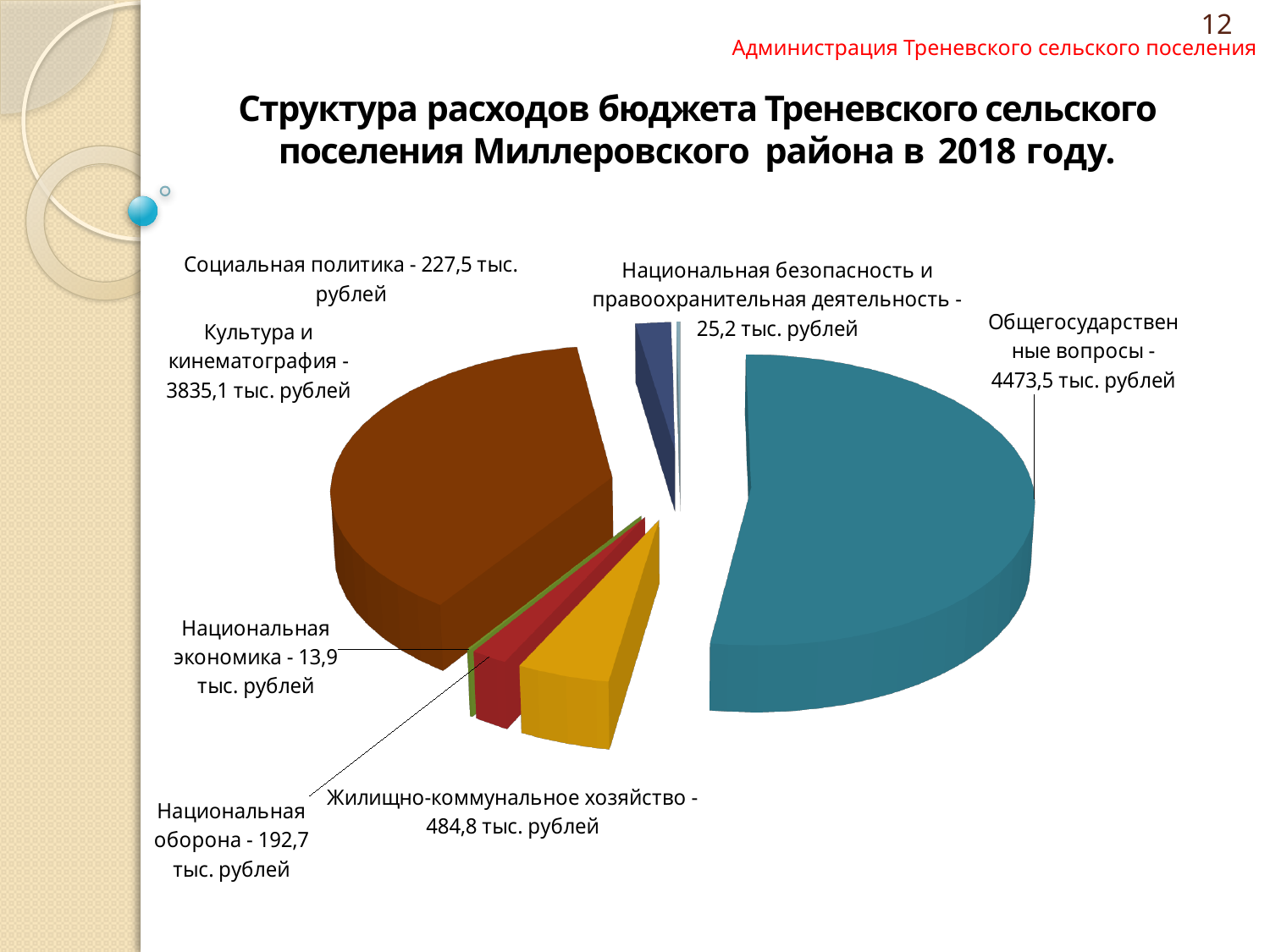
What is the value for Общегосударственные вопросы? 4473,5 тыс. рублей How many categories (slices) does the pie chart show? 7 Which is larger: Социальная политика or Национальная оборона? Социальная политика What is the value for Культура и кинематография? 3835,1 тыс. рублей What is the value for Жилищно-коммунальное хозяйство? 484,8 тыс. рублей What is the title of the chart on the slide? Структура расходов бюджета Треневского сельского поселения Миллеровского района в 2018 году. Which category has the largest expenditure? Общегосударственные вопросы What is the difference between Общегосударственные вопросы and Культура и кинематография? 638,4 тыс. рублей What is the value for Национальная оборона? 192,7 тыс. рублей Which category has the smallest expenditure? Национальная экономика What kind of chart is shown on the slide? Pie chart What is the difference between Жилищно-коммунальное хозяйство and Социальная политика? 257,3 тыс. рублей